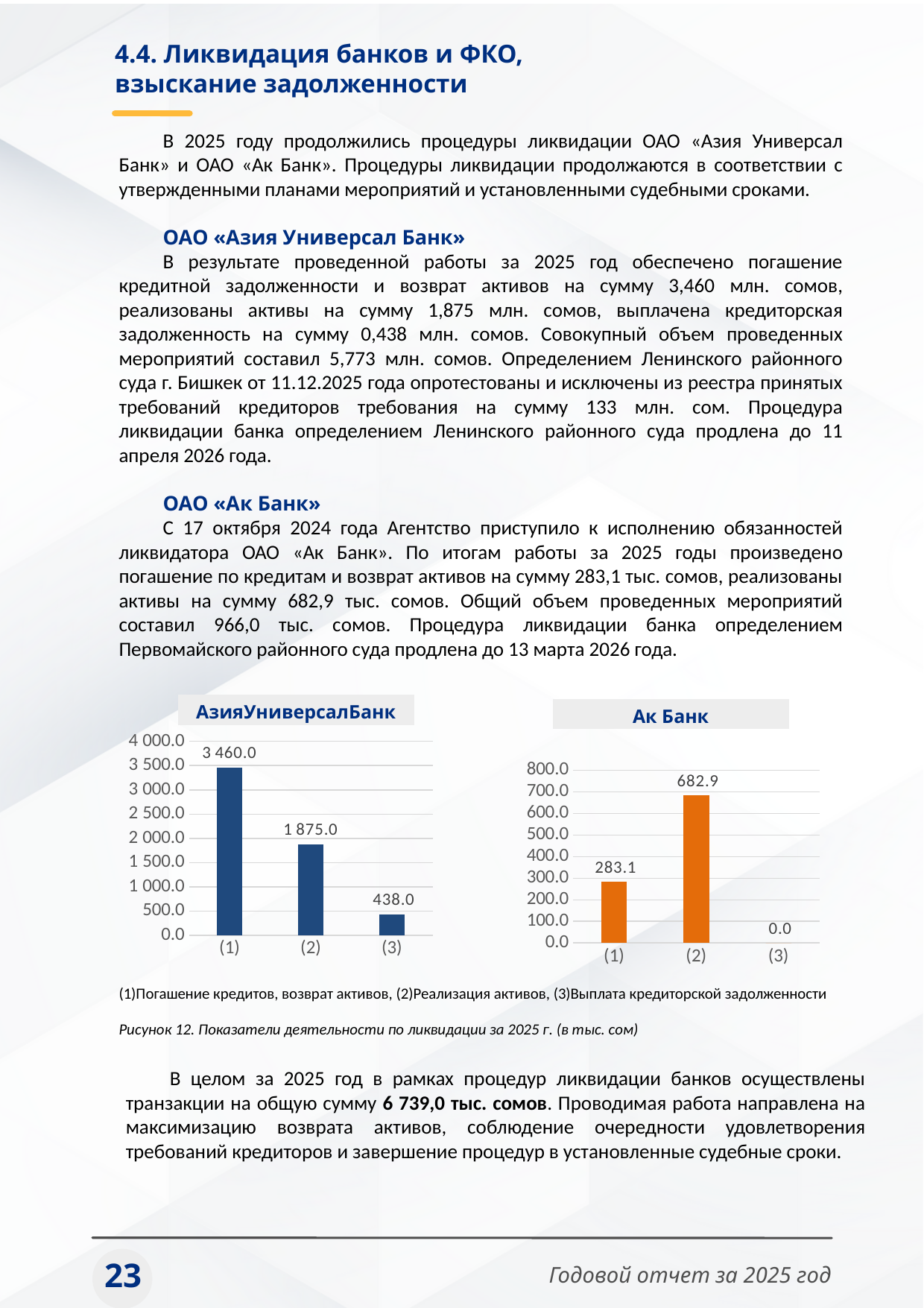
In the Ак Банк chart, what is the difference between the values for (2) and (1)? 399.8 In the Ак Банк chart, what is the value for category (3)? 0.0 In the АзияУниверсалБанк chart, is the value for (2) greater or less than 2 000.0? less In the Ак Банк chart, which category has the lowest value? (3) What type of chart is the АзияУниверсалБанк chart? bar chart In the АзияУниверсалБанк chart, what is the value for category (1)? 3 460.0 How many categories are shown in the Ак Банк chart? 3 In the АзияУниверсалБанк chart, what is the difference between the values for (1) and (2)? 1 585.0 In the АзияУниверсалБанк chart, which category has the highest value? (1) In the Ак Банк chart, which is larger, the value for (1) or the value for (2)? (2) In the АзияУниверсалБанк chart, what is the value for category (3)? 438.0 In the Ак Банк chart, what is the value for category (2)? 682.9